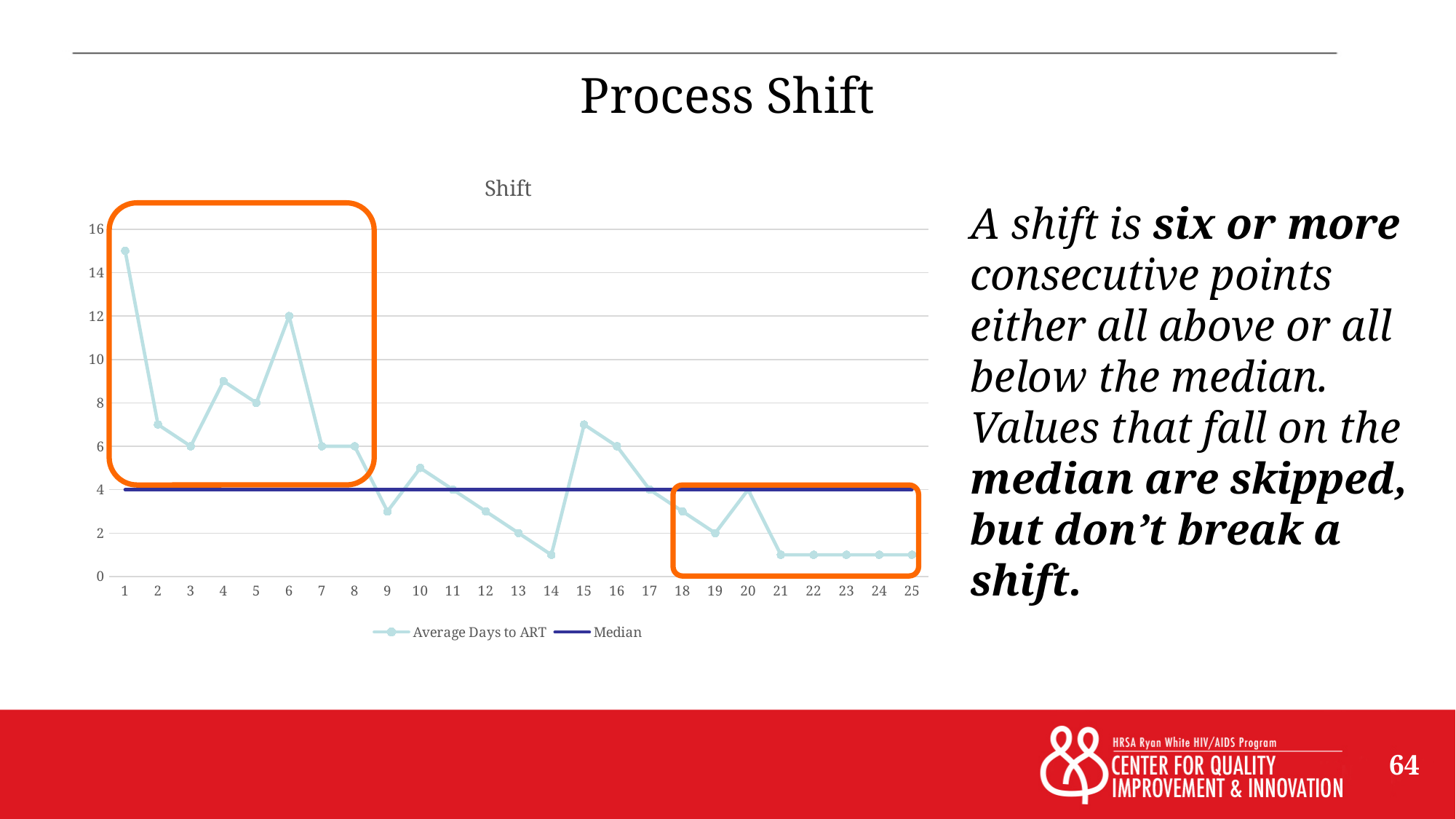
Is the Average Days to ART value at point 1 greater or less than 14? greater What is the Average Days to ART value at point 13? 2 Do the Average Days to ART values generally rise or fall from point 1 to point 25? fall What kind of chart is shown on the slide? line chart How many series does the legend list? 2 What is the value of the Median line? 4 Is the Average Days to ART value at point 14 greater or less than 2? less How many points are plotted along the x axis for Average Days to ART? 25 What is the Average Days to ART value at point 5? 8 What is the difference between the Average Days to ART values at point 6 and point 3? 6 What is the Average Days to ART value at point 6? 12 At which point is Average Days to ART highest? 1